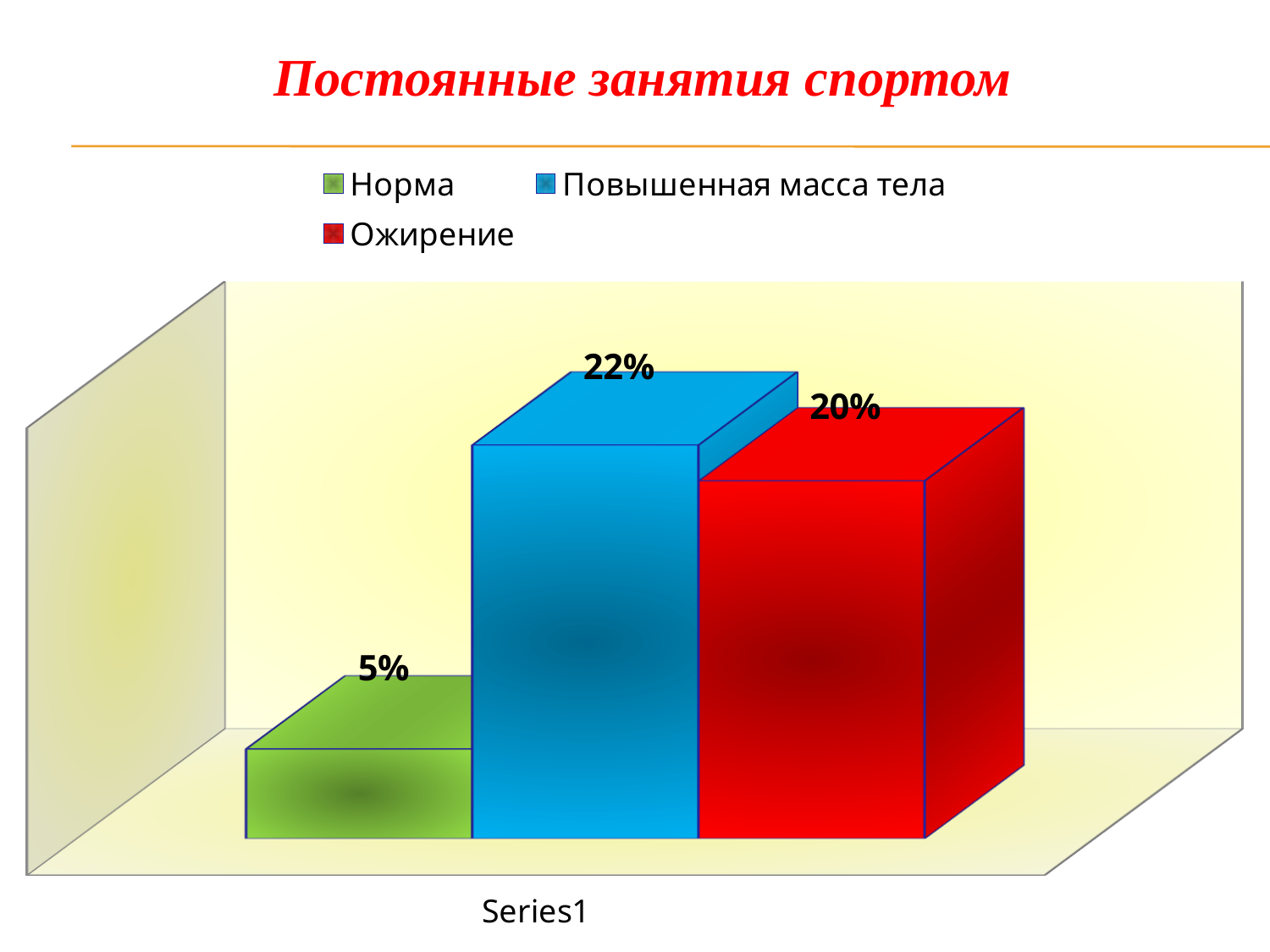
Which series has the highest value? Повышенная масса тела What is the value for Норма? 5% What is the difference between the values for Повышенная масса тела and Ожирение? 2% What is the value for Ожирение? 20% How many series does the legend list? 3 What kind of chart is shown on the slide? bar chart What colour is the bar for Ожирение? red What is the value for Повышенная масса тела? 22% What is the difference between the values for Ожирение and Норма? 15% Which is larger, the value for Норма or the value for Ожирение? Ожирение Which series has the lowest value? Норма How many bars are plotted on the chart? 3